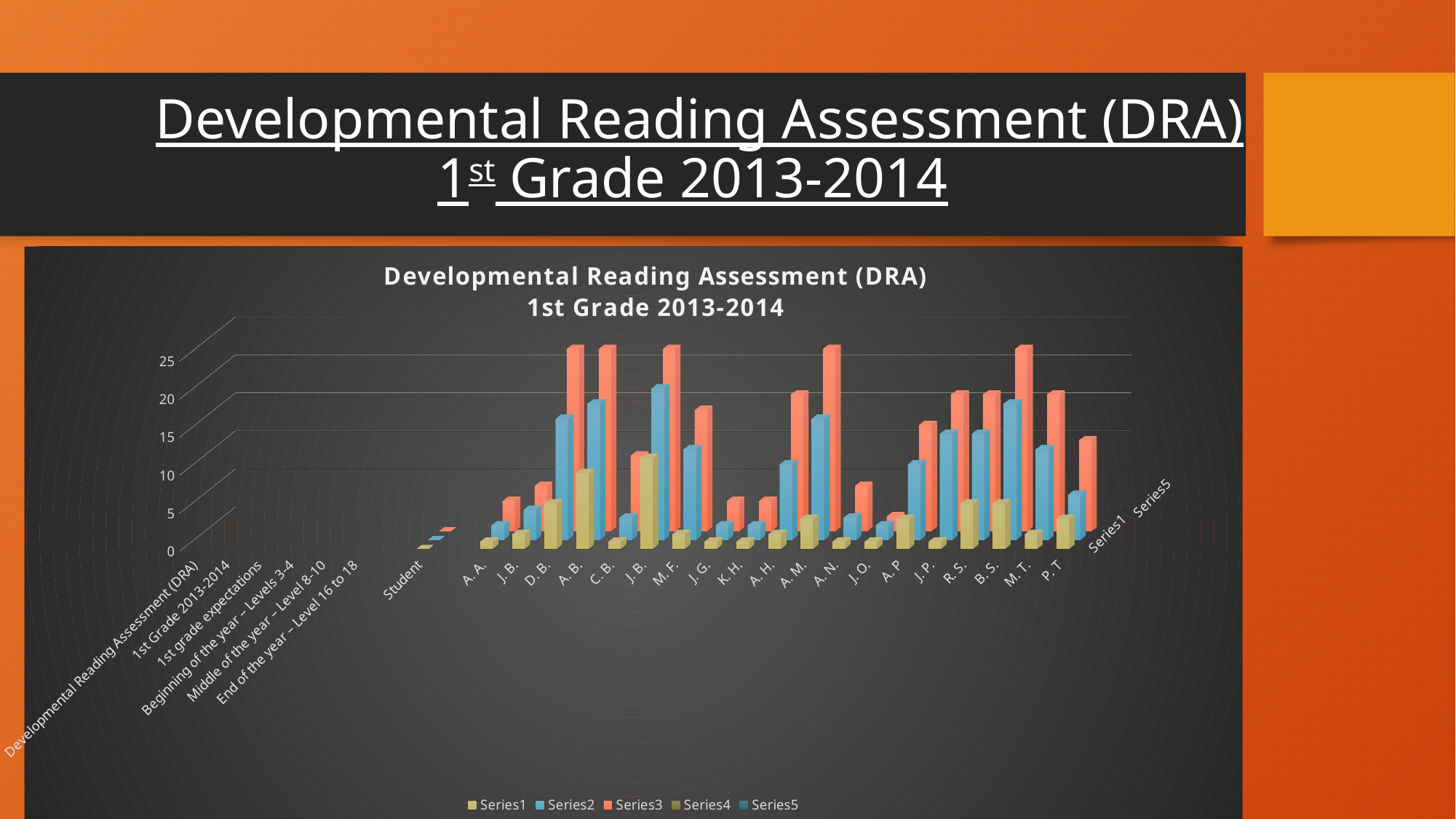
What is the title of the chart? Developmental Reading Assessment (DRA) 1st Grade 2013-2014 What kind of chart is shown on the slide? Bar chart Is the Series3 value for P. T greater or less than 25? less What is the highest value shown on the vertical axis? 25 How many series does the chart legend list? 5 Is the Series3 value for A. A. greater or less than 20? less Is the Series3 value for K. H. greater or less than 15? less Which is larger, the Series3 value for A. N. or the Series3 value for J. O.? A. N. Which is larger for A. B., the Series3 value or the Series1 value? Series3 How many student initials (from A. A. to P. T) are listed as categories on the x axis? 19 What are the names of the series listed in the chart legend? Series1, Series2, Series3, Series4, Series5